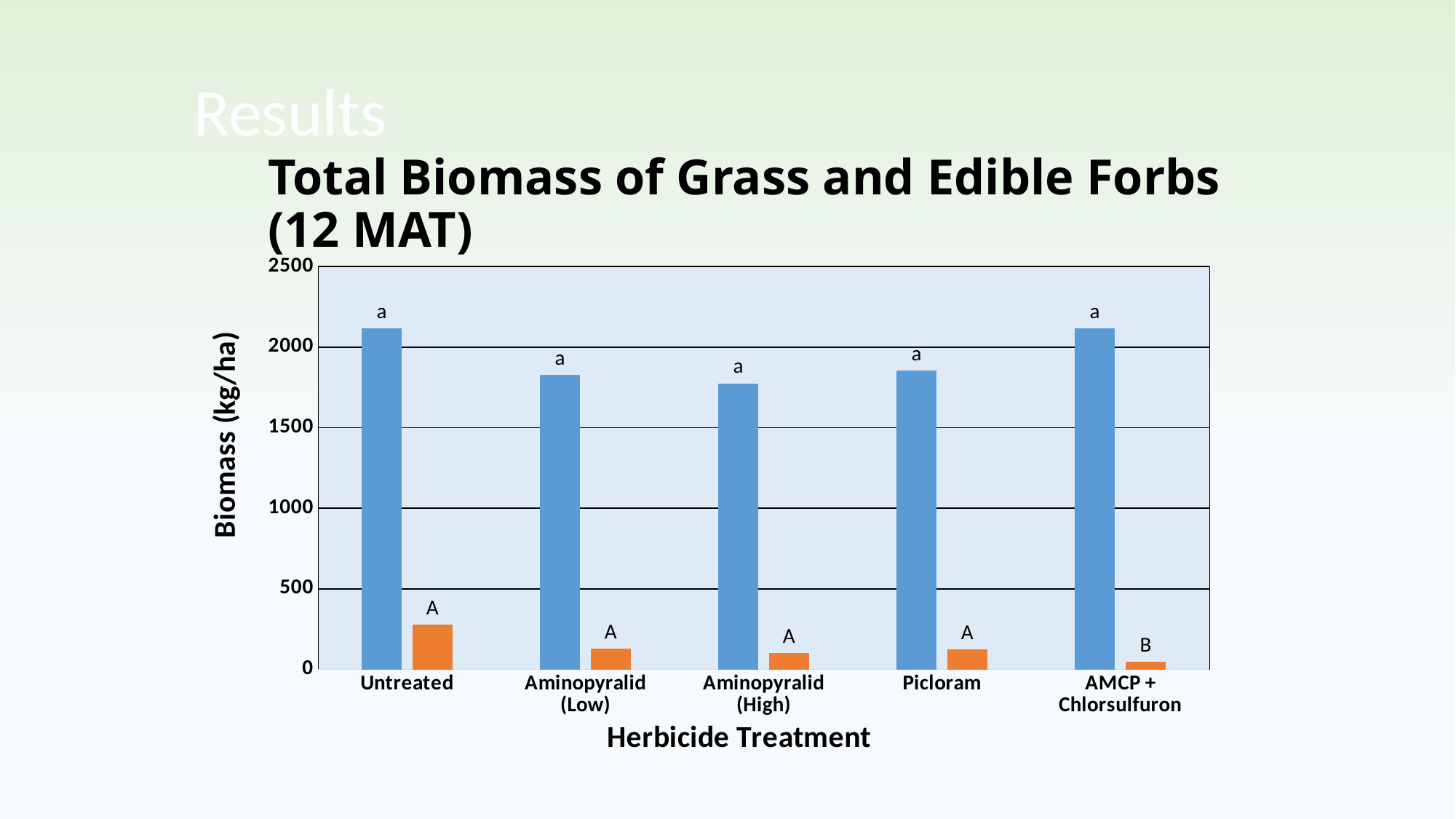
Is the value of the blue bar for Aminopyralid (Low) greater or less than 2000? less Which has the larger blue bar, Untreated or Aminopyralid (High)? Untreated Is the value of the blue bar for Aminopyralid (High) greater or less than 1500? greater What is the label of the y axis? Biomass (kg/ha) How many herbicide treatment categories are shown on the x axis? 5 Is the value of the blue bar for AMCP + Chlorsulfuron greater or less than 2000? greater What is the title of the chart? Total Biomass of Grass and Edible Forbs (12 MAT) Which treatment has the highest orange bar? Untreated What kind of chart is shown on the slide? bar chart Which treatment has the lowest orange bar? AMCP + Chlorsulfuron